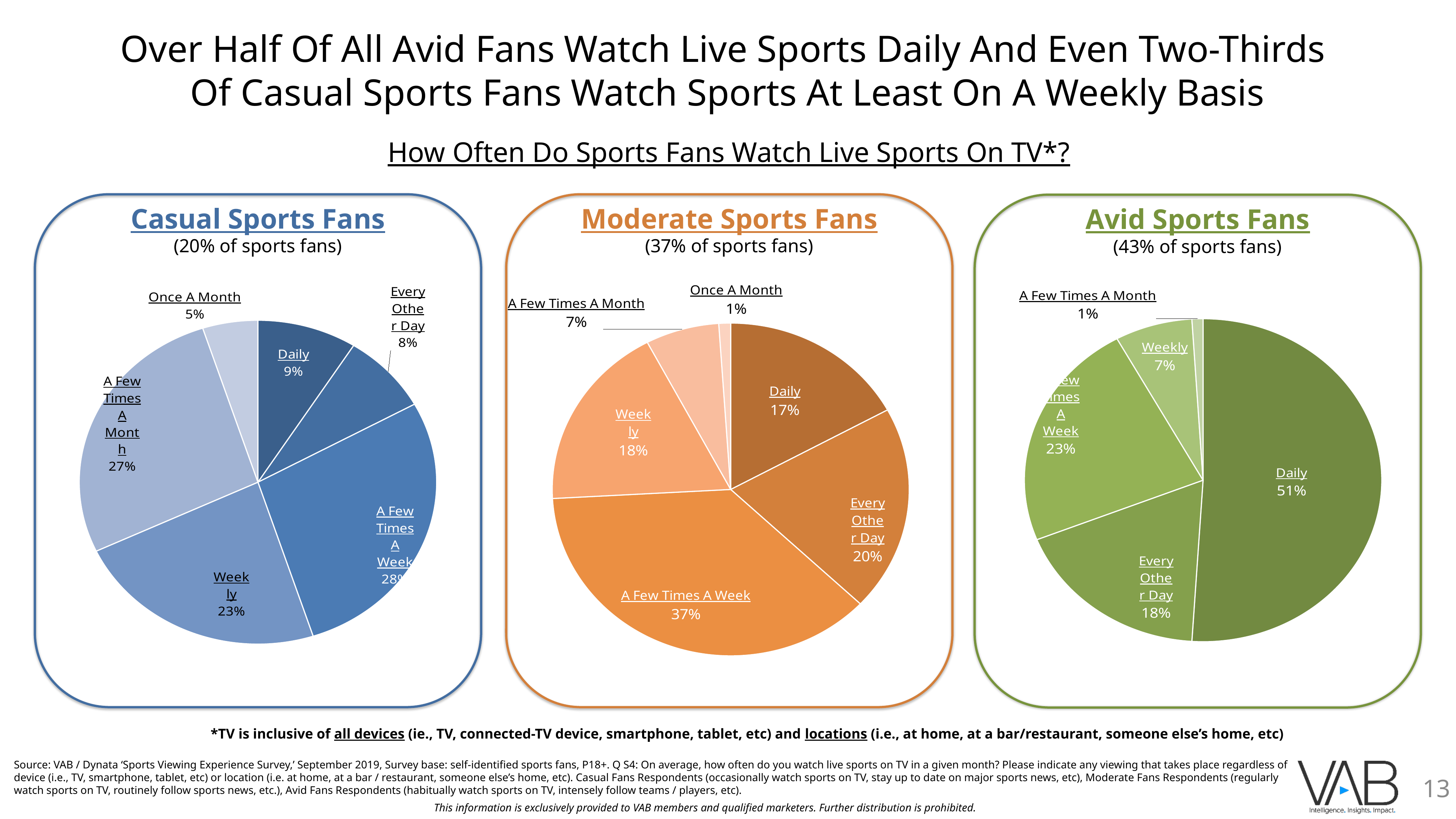
What type of chart is used for the Casual Sports Fans data? Pie chart According to the subtitle of the Avid Sports Fans chart, what percentage of sports fans are avid fans? 43% In the Avid Sports Fans chart, what is the difference between the Daily share and the Every Other Day share? 33% In the Casual Sports Fans chart, which is larger: the Daily slice or the A Few Times A Month slice? A Few Times A Month In the Moderate Sports Fans chart, what is the difference between the Weekly share and the Daily share? 1% In the Moderate Sports Fans chart, which viewing frequency has the largest slice? A Few Times A Week How many slices does the Moderate Sports Fans pie chart have? 6 In the Moderate Sports Fans chart, what percentage watch live sports A Few Times A Week? 37% In the Casual Sports Fans chart, what percentage watch live sports Once A Month? 5% In the Avid Sports Fans chart, what share of avid fans watch live sports Daily? 51% In the Casual Sports Fans chart, what percentage watch live sports Weekly? 23% In the Moderate Sports Fans chart, which viewing frequency has the smallest slice? Once A Month